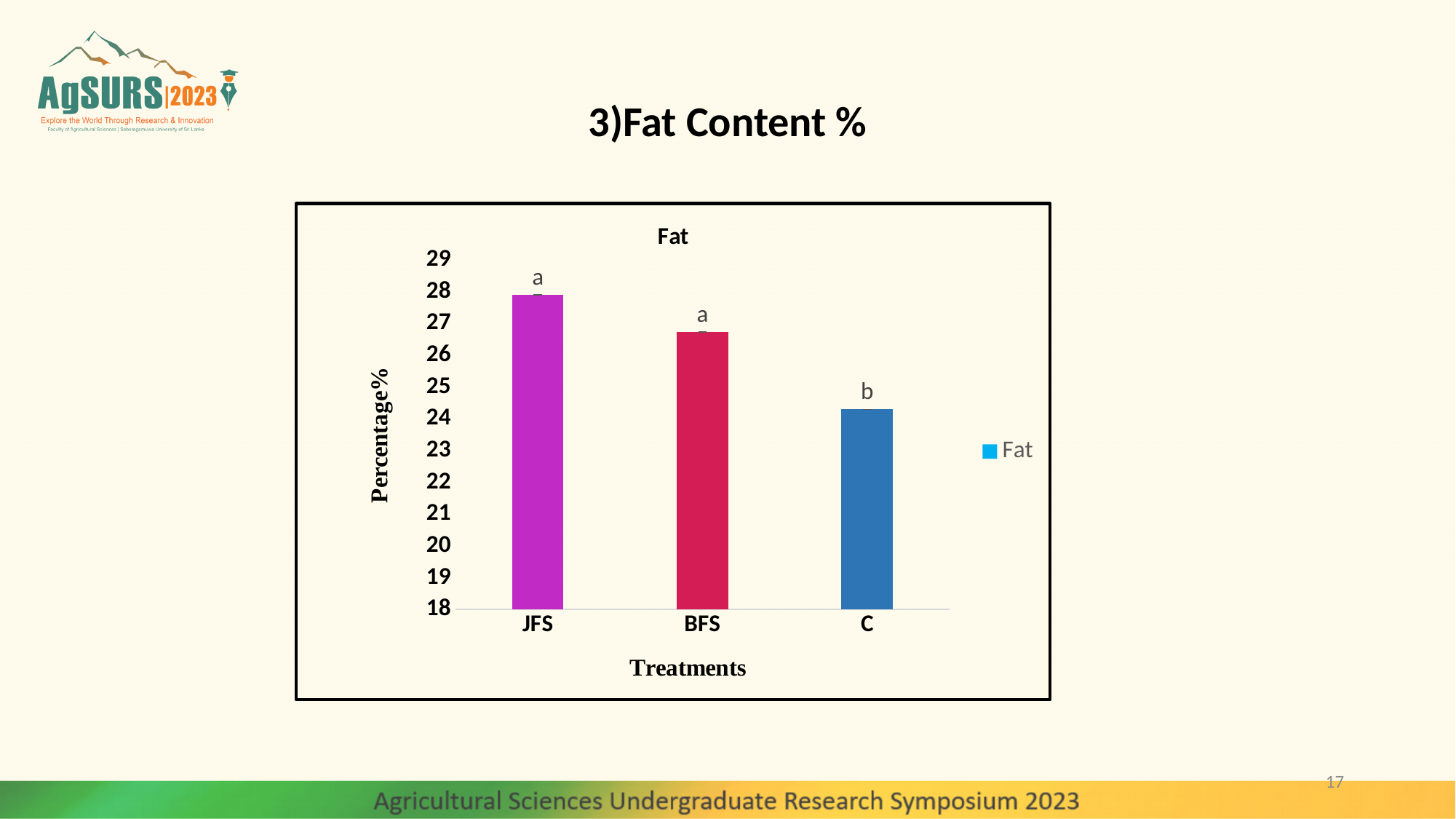
Is the fat percentage for BFS greater or less than 26? greater Which has a higher fat percentage, JFS or BFS? JFS Which treatment has the lowest fat percentage? C How many series does the chart legend list? 1 How many treatments are plotted on the x axis of the chart? 3 What kind of chart is shown on the slide? bar chart Is the fat percentage for JFS greater or less than 27? greater Do the fat percentages rise or fall moving from JFS to C along the x axis? fall Which treatment has the highest fat percentage? JFS Which has a higher fat percentage, BFS or C? BFS Is the fat percentage for C greater or less than 25? less What is the title of the chart's y axis? Percentage%